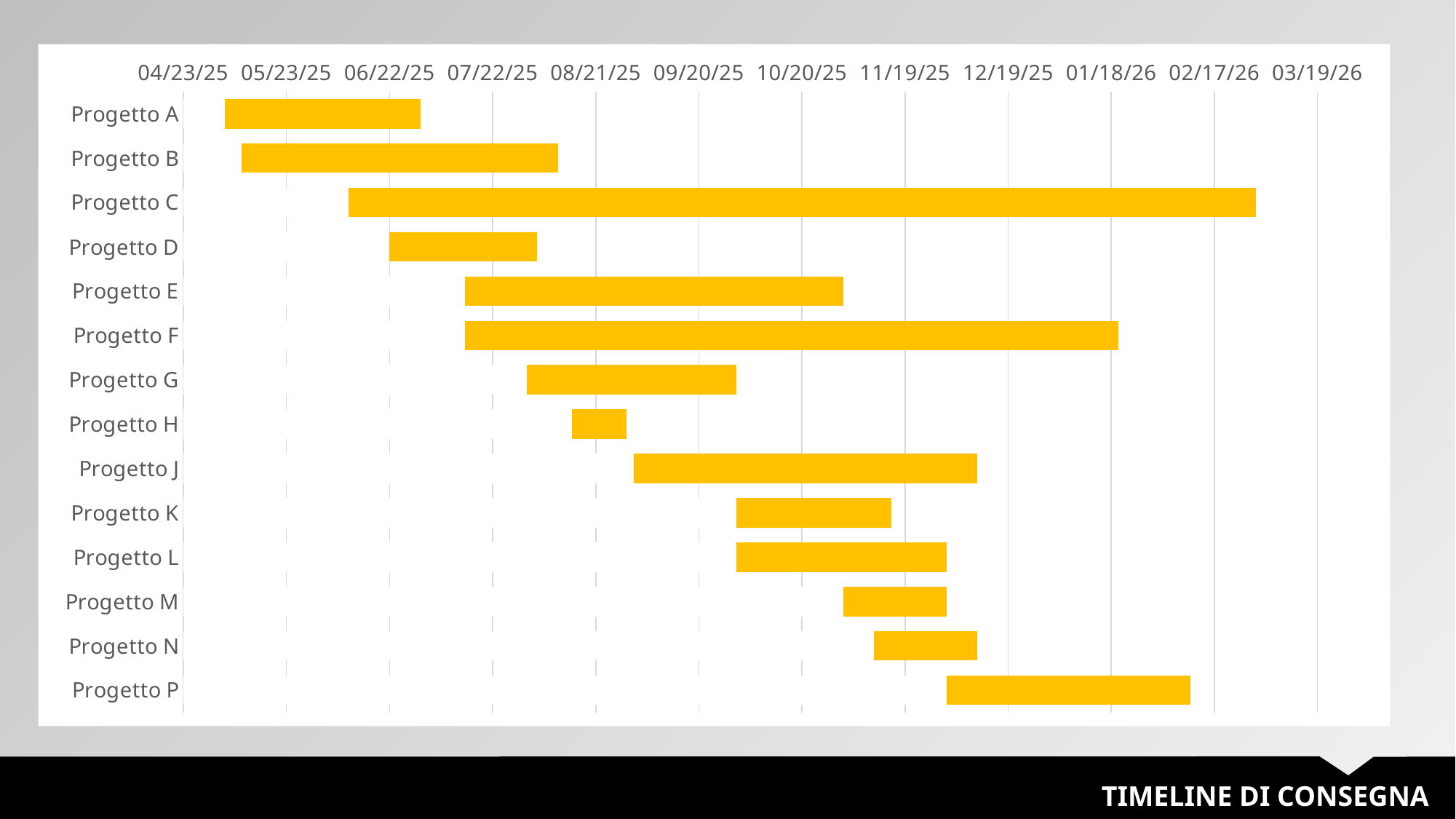
Does the bar for Progetto A end before or after 06/22/25? after What is the title text shown at the bottom right of the slide? TIMELINE DI CONSEGNA Which project has the shortest bar in the chart? Progetto H Does the bar for Progetto C end before or after 02/17/26? after Which project's bar starts earliest on the timeline? Progetto A Which project's bar ends latest on the timeline? Progetto C Which bar is longer, Progetto F or Progetto D? Progetto F How many projects are listed on the vertical axis of the chart? 14 Does the bar for Progetto P start before or after 11/19/25? after Which project's bar starts latest on the timeline? Progetto P Which project has the longest bar in the chart? Progetto C What kind of chart is shown on the slide? Bar chart (Gantt chart)